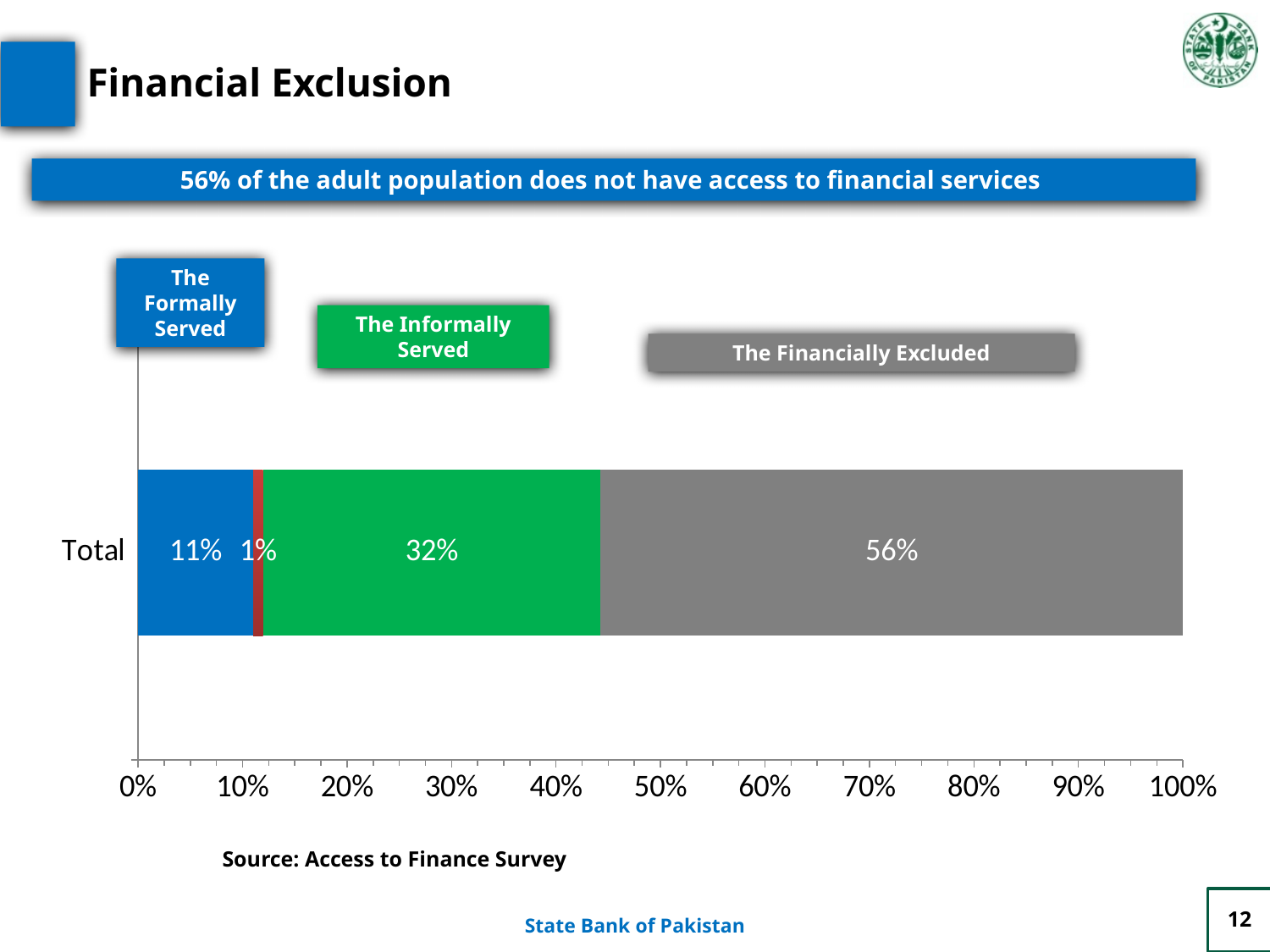
What percentage is shown for The Informally Served segment? 32% Which is larger, The Informally Served segment or The Formally Served segment? The Informally Served Which segment of the Total bar is the largest? The Financially Excluded What is the total of all segments in the Total bar? 100% What percentage of the adult population is shown as The Financially Excluded? 56% What percentage is shown for The Formally Served segment? 11% What kind of chart is shown on the slide? Stacked bar chart What value is printed on the small red segment of the bar? 1% What is the label of the single category on the vertical axis? Total What is the difference between The Financially Excluded and The Informally Served segments? 24% Which labelled segment of the Total bar is the smallest? The Formally Served What is the difference between The Informally Served and The Formally Served segments? 21%